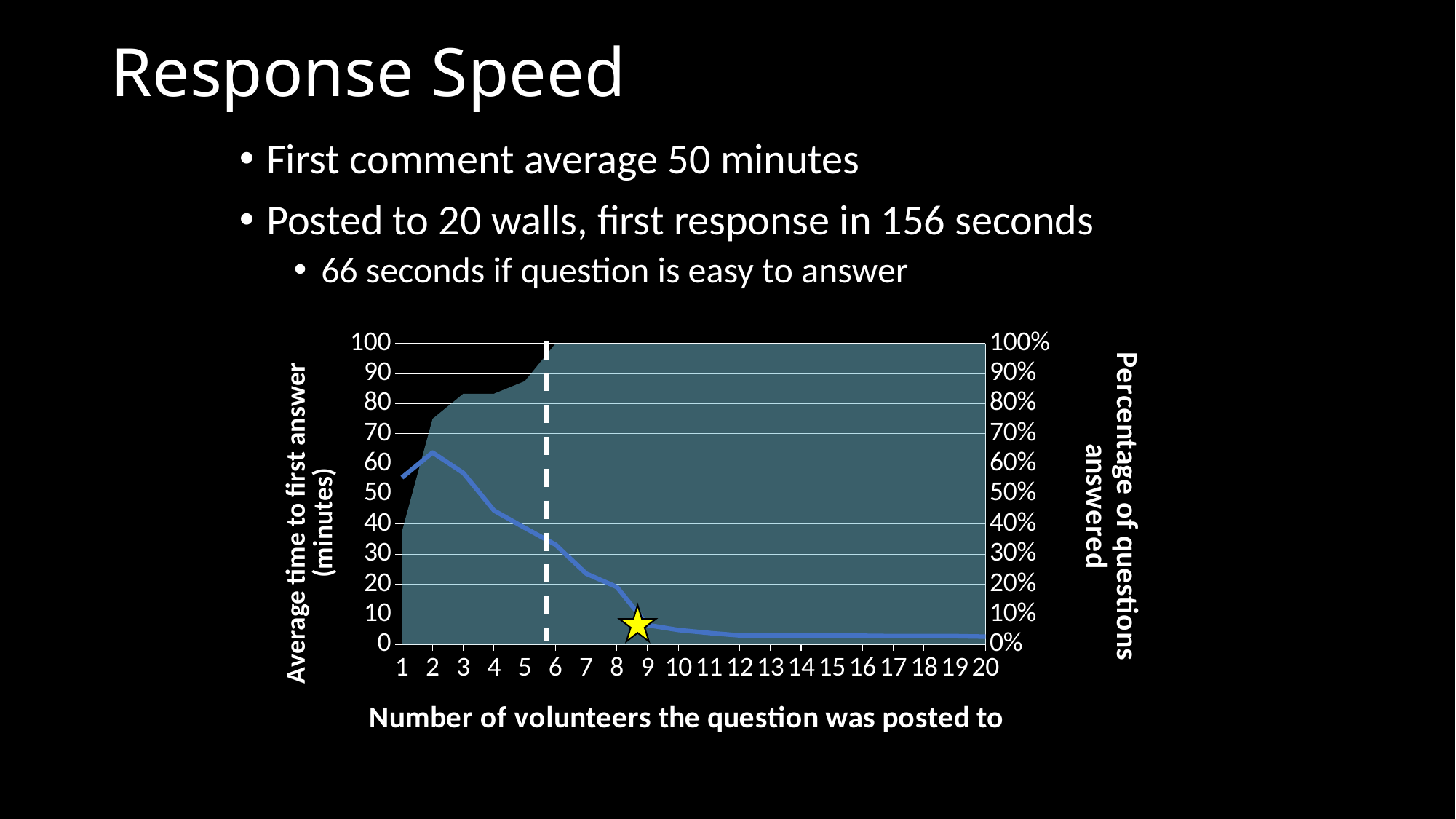
Is the average time to first answer for 5 volunteers greater or less than 30 minutes? greater Is the percentage of questions answered for 3 volunteers greater or less than 70%? greater Is the average time to first answer for 10 volunteers greater or less than 10 minutes? less At which number of volunteers is the average time to first answer (the line) highest? 2 What kind of chart is shown on the slide? A combined area and line chart What is the title of the x axis of the chart? Number of volunteers the question was posted to How many values of 'Number of volunteers the question was posted to' are shown on the x axis? 20 Does the percentage of questions answered rise or fall as the number of volunteers increases from 1 to 7? Rise Which has a larger average time to first answer: 1 volunteer or 10 volunteers? 1 volunteer Does the average time to first answer rise or fall as the number of volunteers increases from 2 to 20? Fall